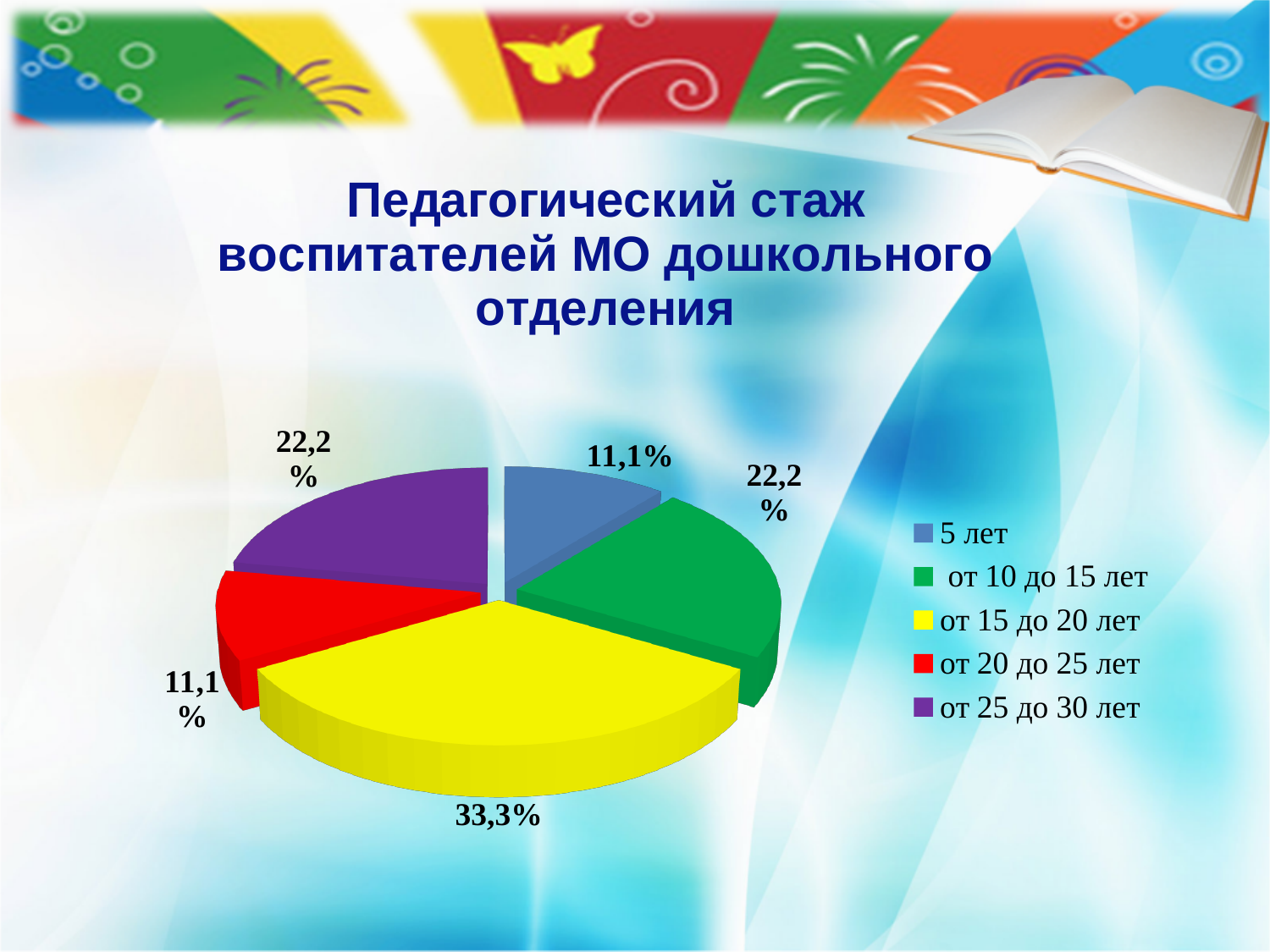
How many categories does the legend list? 5 What is the value for the "от 10 до 15 лет" slice? 22,2% What is the value for the "от 25 до 30 лет" slice? 22,2% Which category has the largest share of the pie? от 15 до 20 лет Which is larger, the share for "от 10 до 15 лет" or the share for "от 20 до 25 лет"? от 10 до 15 лет What colour is the "от 15 до 20 лет" slice? Yellow What is the value for the "от 20 до 25 лет" slice? 11,1% What is the value for the "от 15 до 20 лет" slice? 33,3% What is the difference between the share for "от 15 до 20 лет" and the share for "5 лет"? 22,2% What is the title of the chart on the slide? Педагогический стаж воспитателей МО дошкольного отделения What kind of chart is shown on the slide? Pie chart What is the value for the "5 лет" slice? 11,1%